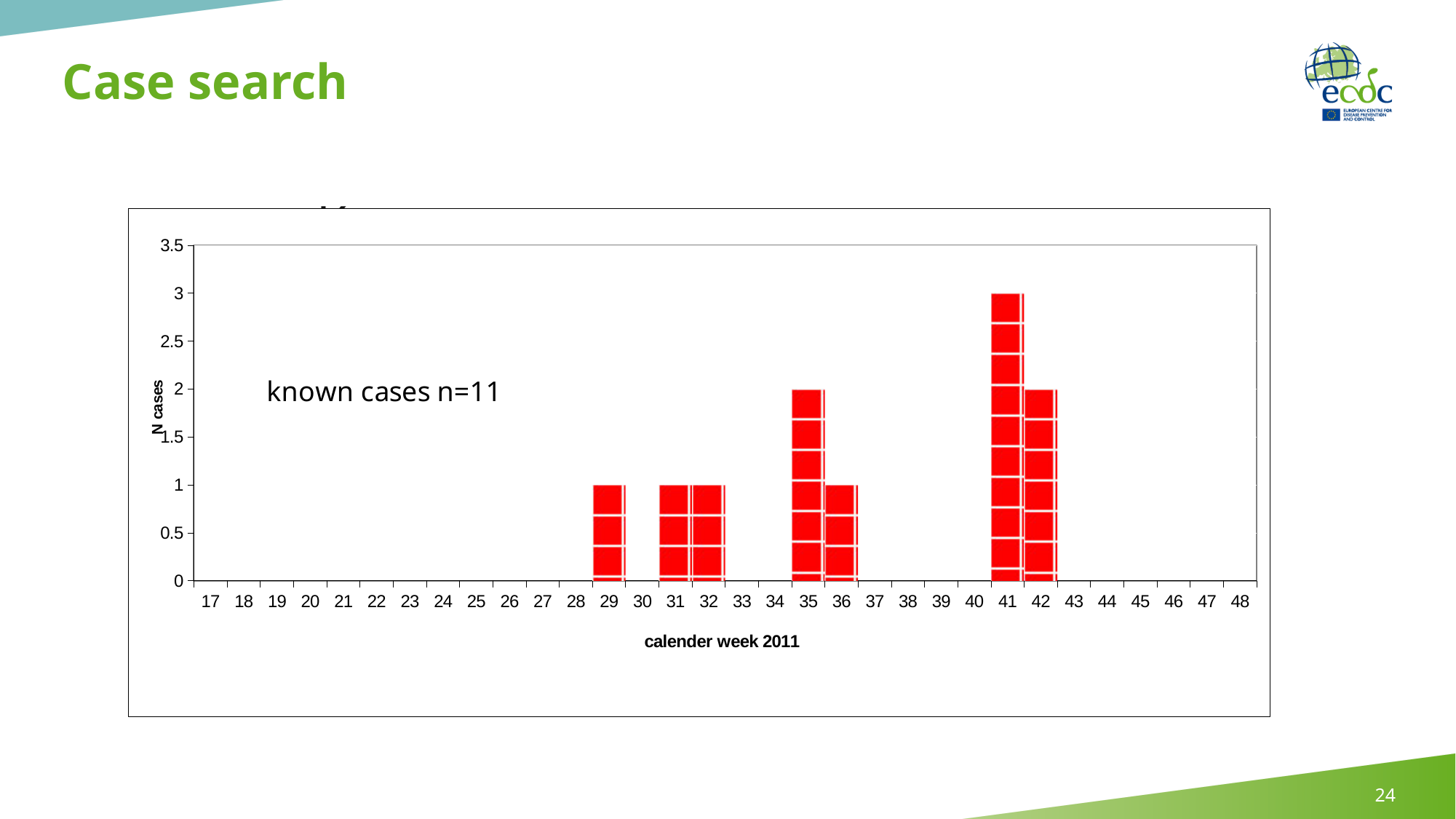
Which calendar week has the highest number of cases? 41 What is the difference in the number of cases between week 41 and week 36? 2 Is the value for week 41 greater or less than 2.5? greater What is the number of cases in calendar week 29? 1 What is the number of cases in calendar week 41? 3 How many calendar weeks are labelled on the x axis? 32 What is the number of cases in calendar week 35? 2 What is the label of the x axis? calender week 2011 According to the text on the chart, how many known cases are there? n=11 Which has more cases, week 35 or week 32? week 35 What is the number of cases in calendar week 42? 2 What kind of chart is shown on the slide? bar chart